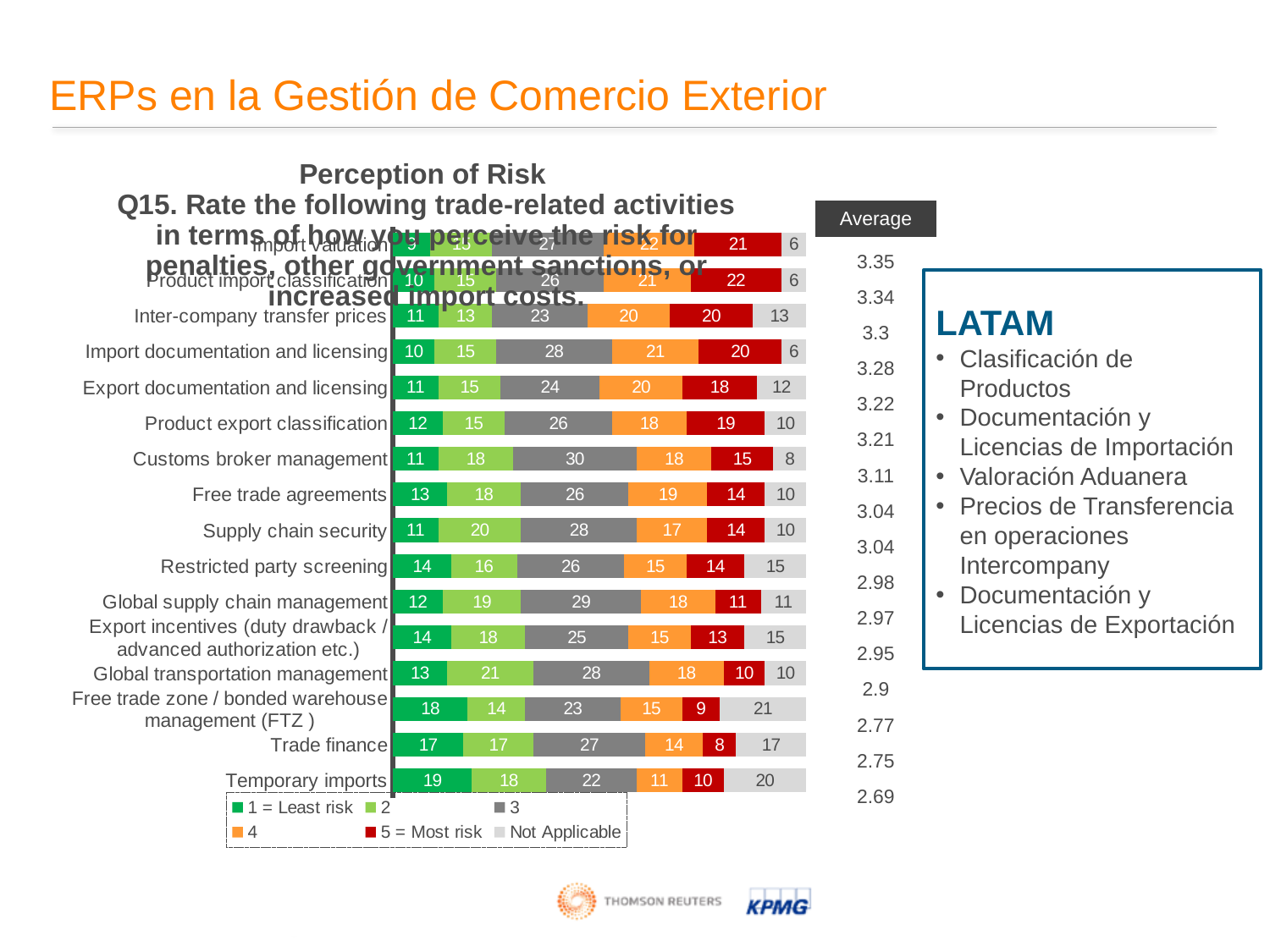
What is the value of series 4 for Restricted party screening? 15 What is the value of '1 = Least risk' for Temporary imports? 19 What is the value of series 3 for Customs broker management? 30 What kind of chart is shown on the slide? bar chart For Global transportation management, what is the difference between the value of series 2 and the value of '5 = Most risk'? 11 How many series does the legend of the chart list? 6 Which category has the highest value for '1 = Least risk'? Temporary imports Which category has the lowest value for '5 = Most risk'? Trade finance What is the 'Not Applicable' value for Free trade zone / bonded warehouse management (FTZ)? 21 What is the total of the stacked bar for Temporary imports? 100 What label does the legend give to the dark red series? 5 = Most risk Which has the larger value for series 2: Supply chain security or Free trade agreements? Supply chain security